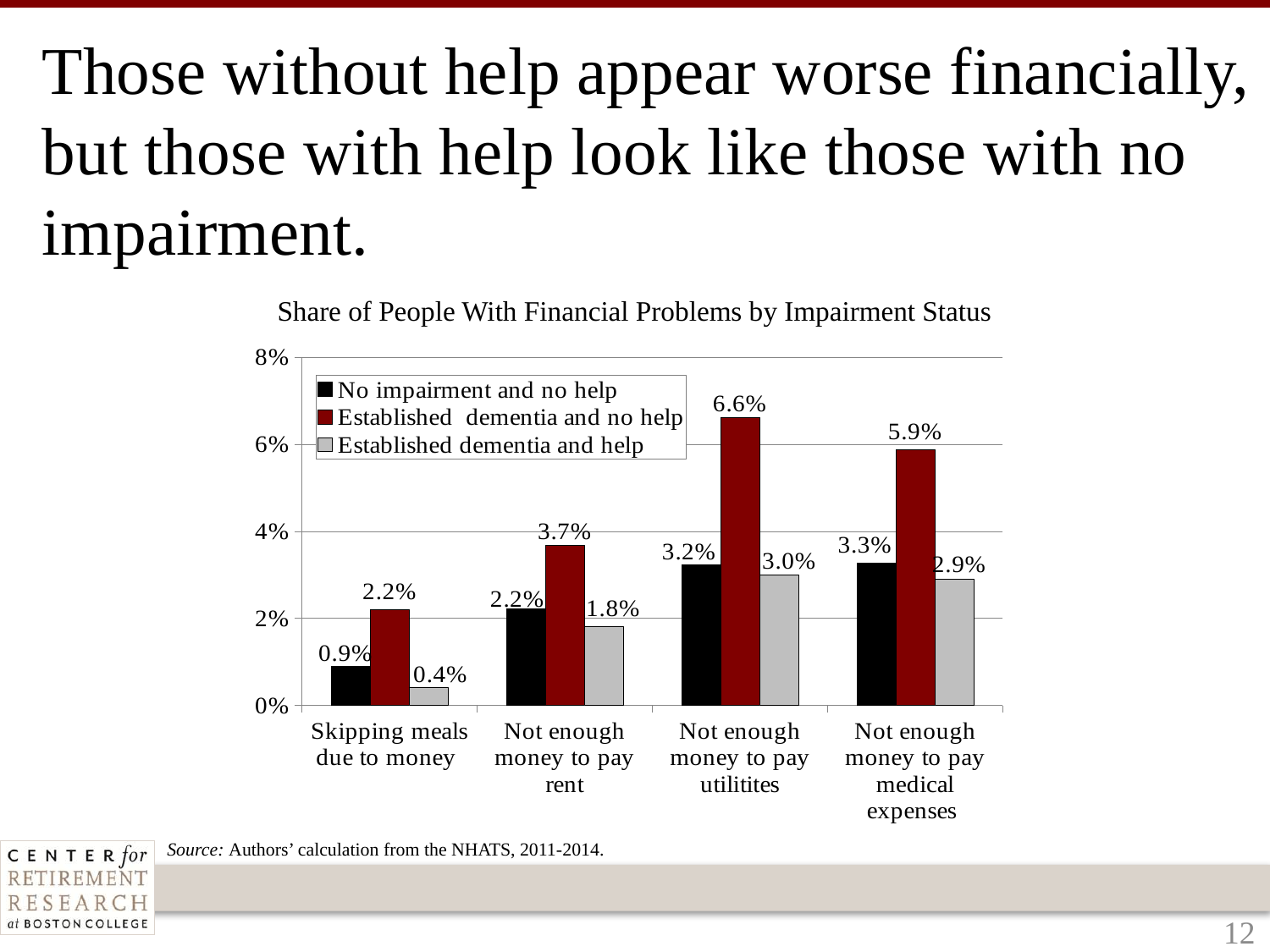
In the 'Not enough money to pay medical expenses' category, which is larger: 'Established dementia and no help' or 'Established dementia and help'? Established dementia and no help What is the value for 'No impairment and no help' in the 'Not enough money to pay medical expenses' category? 3.3% What is the value for 'Established dementia and no help' in the 'Not enough money to pay utilitites' category? 6.6% How many categories are shown on the x axis? 4 Which category has the highest value for the 'Established dementia and no help' series? Not enough money to pay utilitites Which category has the lowest value for the 'No impairment and no help' series? Skipping meals due to money What is the title of the chart? Share of People With Financial Problems by Impairment Status How many series does the legend list? 3 What is the difference between 'Established dementia and no help' and 'Established dementia and help' in the 'Not enough money to pay rent' category? 1.9% What is the value for 'Established dementia and help' in the 'Skipping meals due to money' category? 0.4% Is the value for 'Established dementia and no help' in the 'Not enough money to pay medical expenses' category greater or less than 4%? greater What kind of chart is shown on the slide? Bar chart